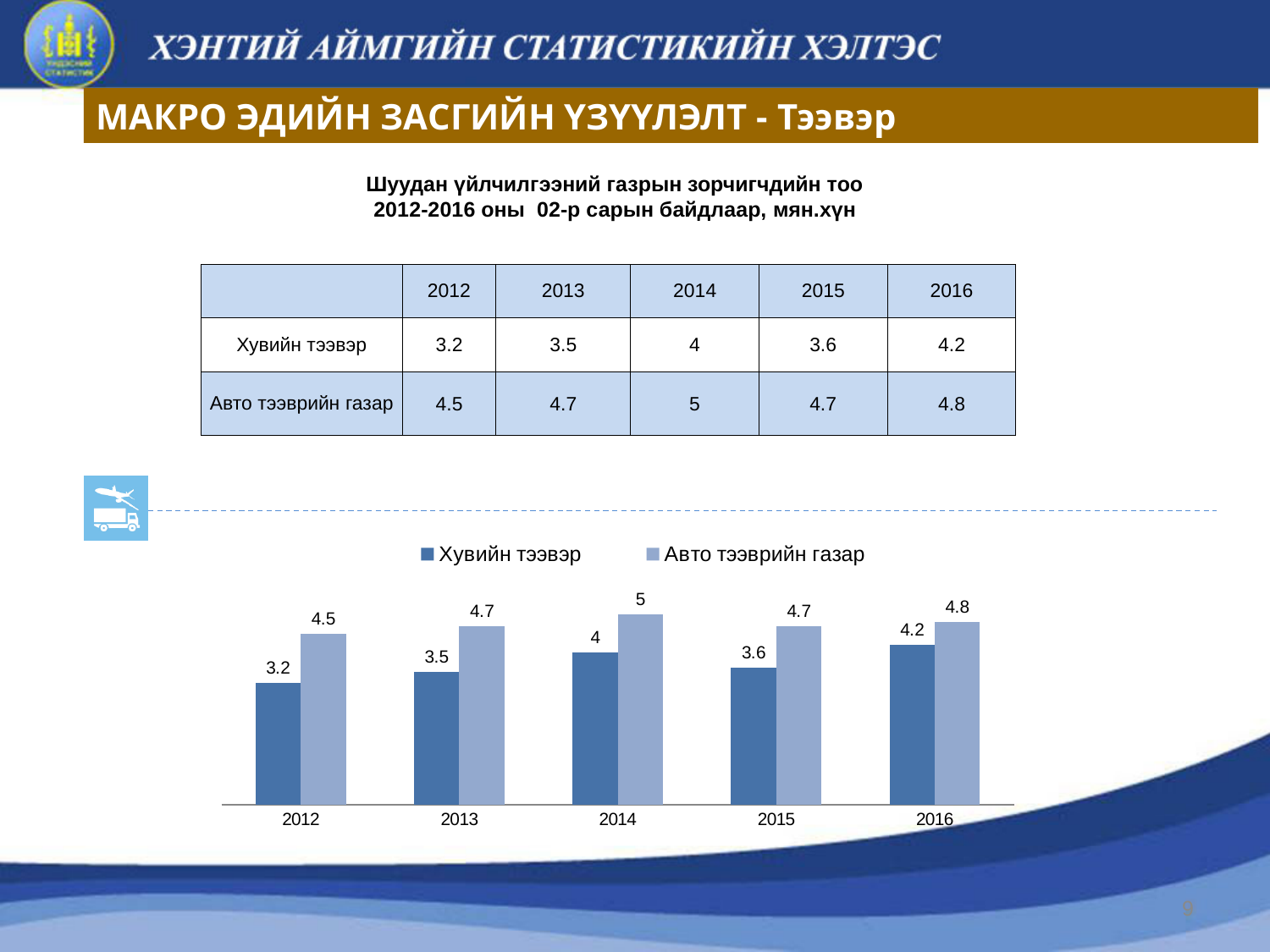
Does the value for Хувийн тээвэр rise or fall from 2012 to 2013? Rise How many years are shown on the x axis of the chart? 5 Which series is shown in the lighter blue colour in the chart? Авто тээврийн газар In which year is the value for Хувийн тээвэр lowest? 2012 What is the value for Хувийн тээвэр in 2012? 3.2 What is the difference between Авто тээврийн газар and Хувийн тээвэр in 2012? 1.3 What kind of chart is shown on the slide? Bar chart How many series does the legend list? 2 In which year is the value for Авто тээврийн газар highest? 2014 What is the value for Хувийн тээвэр in 2014? 4 What is the value for Авто тээврийн газар in 2016? 4.8 Which is larger in 2015: Хувийн тээвэр or Авто тээврийн газар? Авто тээврийн газар